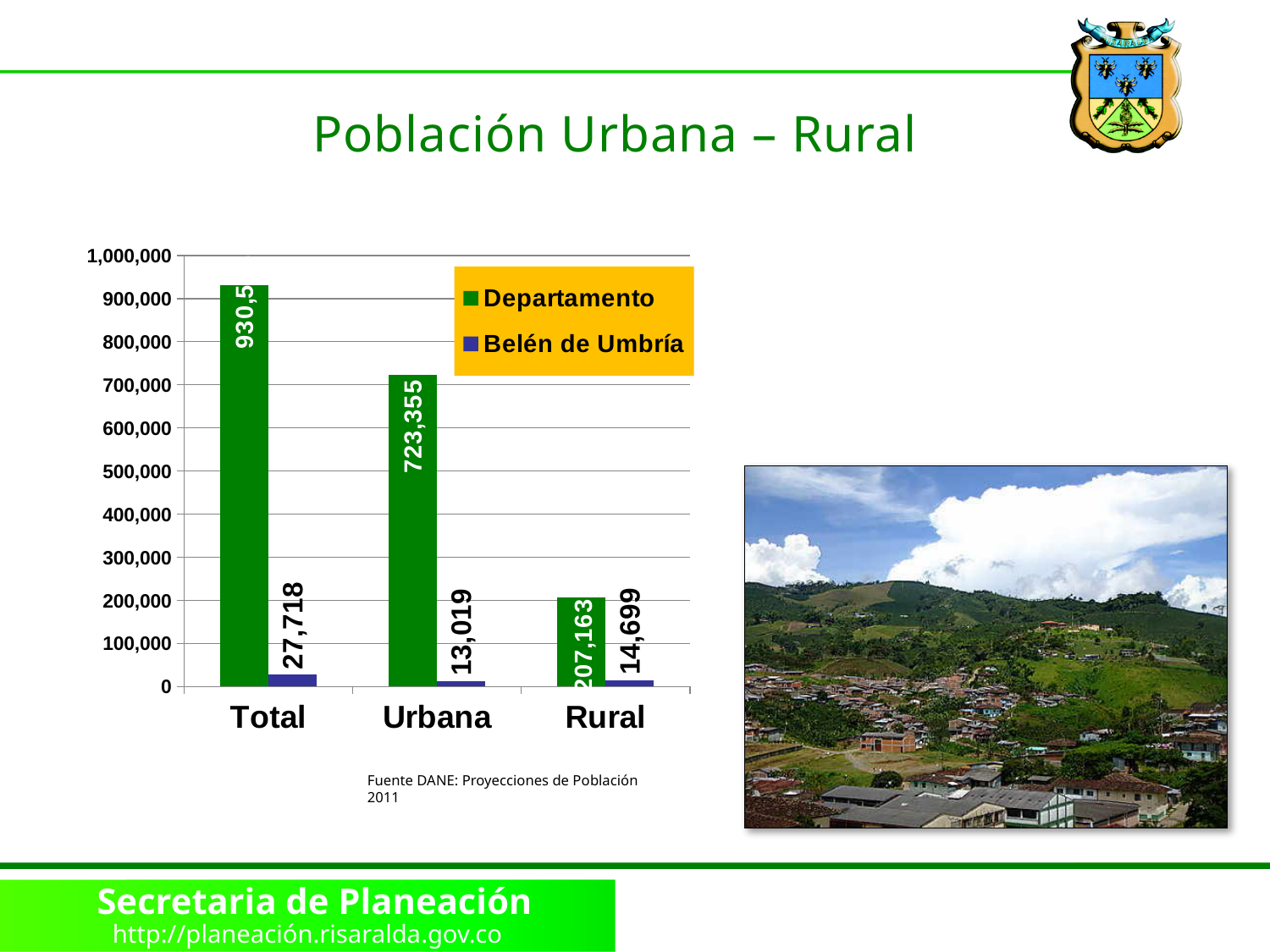
Is the Departamento value for Total greater or less than 900,000? greater Which colour represents the Departamento series in the legend? green For Belén de Umbría, which is larger: Urbana or Rural? Rural What kind of chart is shown on the slide? bar chart What is the Belén de Umbría value for Rural? 14,699 What is the Belén de Umbría value for Urbana? 13,019 What is the difference between the Departamento Urbana and Rural values? 516,192 How many series does the legend list? 2 How many categories are shown on the x axis? 3 What is the Departamento value for Rural? 207,163 What is the Belén de Umbría value for Total? 27,718 What is the Departamento value for Urbana? 723,355